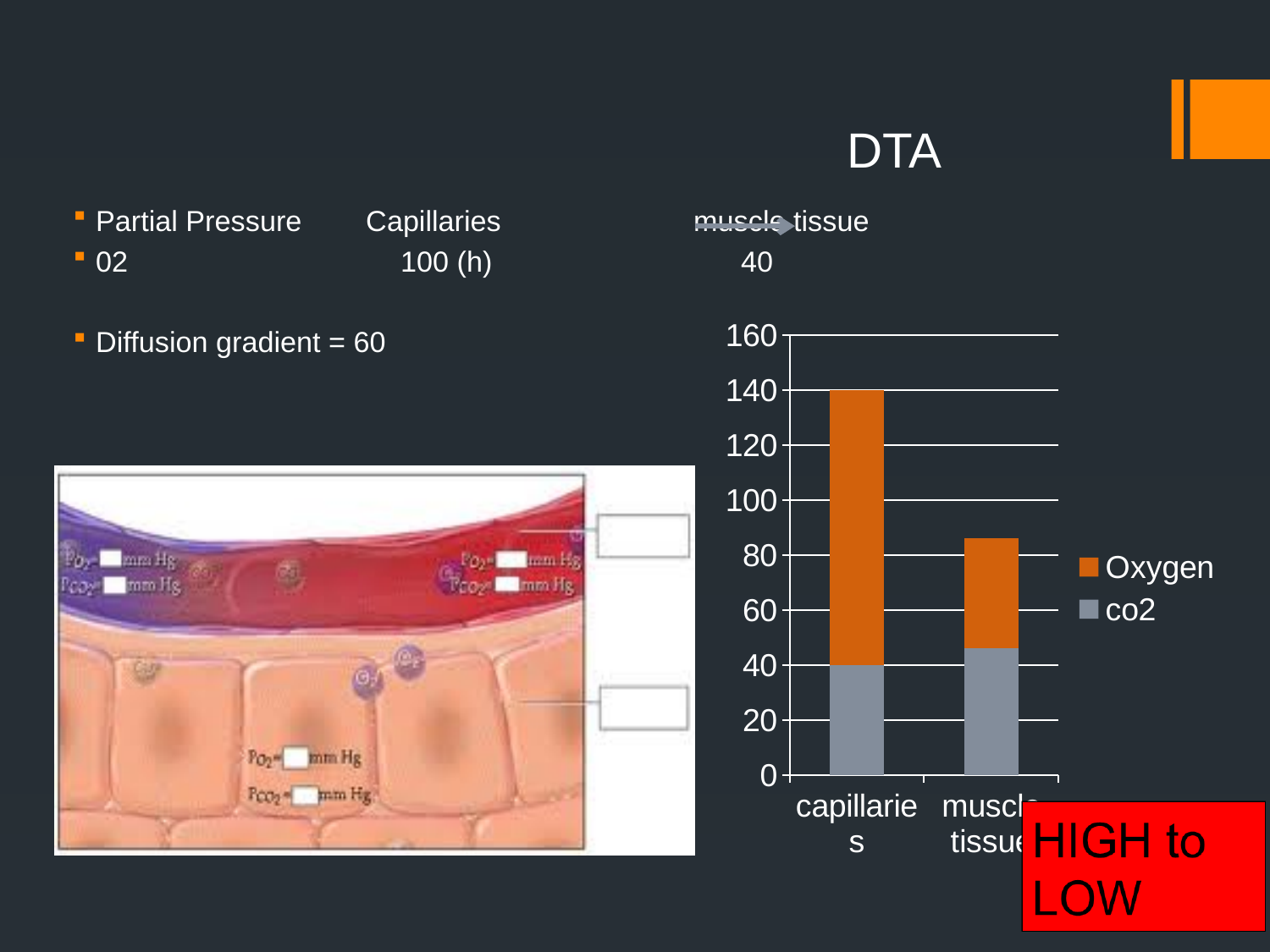
Is the co2 value for muscle tissue greater or less than 60? less Is the total height of the capillaries bar greater or less than 120? greater Which two series are listed in the chart legend? Oxygen and co2 Is the total height of the muscle tissue bar greater or less than 100? less What kind of chart is shown on the slide? stacked bar chart Which category has the lowest total bar height? muscle tissue Is the Oxygen segment larger for capillaries or for muscle tissue? capillaries What colour represents Oxygen in the chart? orange How many series does the chart legend list? 2 How many categories are shown on the x axis of the chart? 2 What is the highest value shown on the chart's y axis? 160 Which category has the taller stacked bar, capillaries or muscle tissue? capillaries